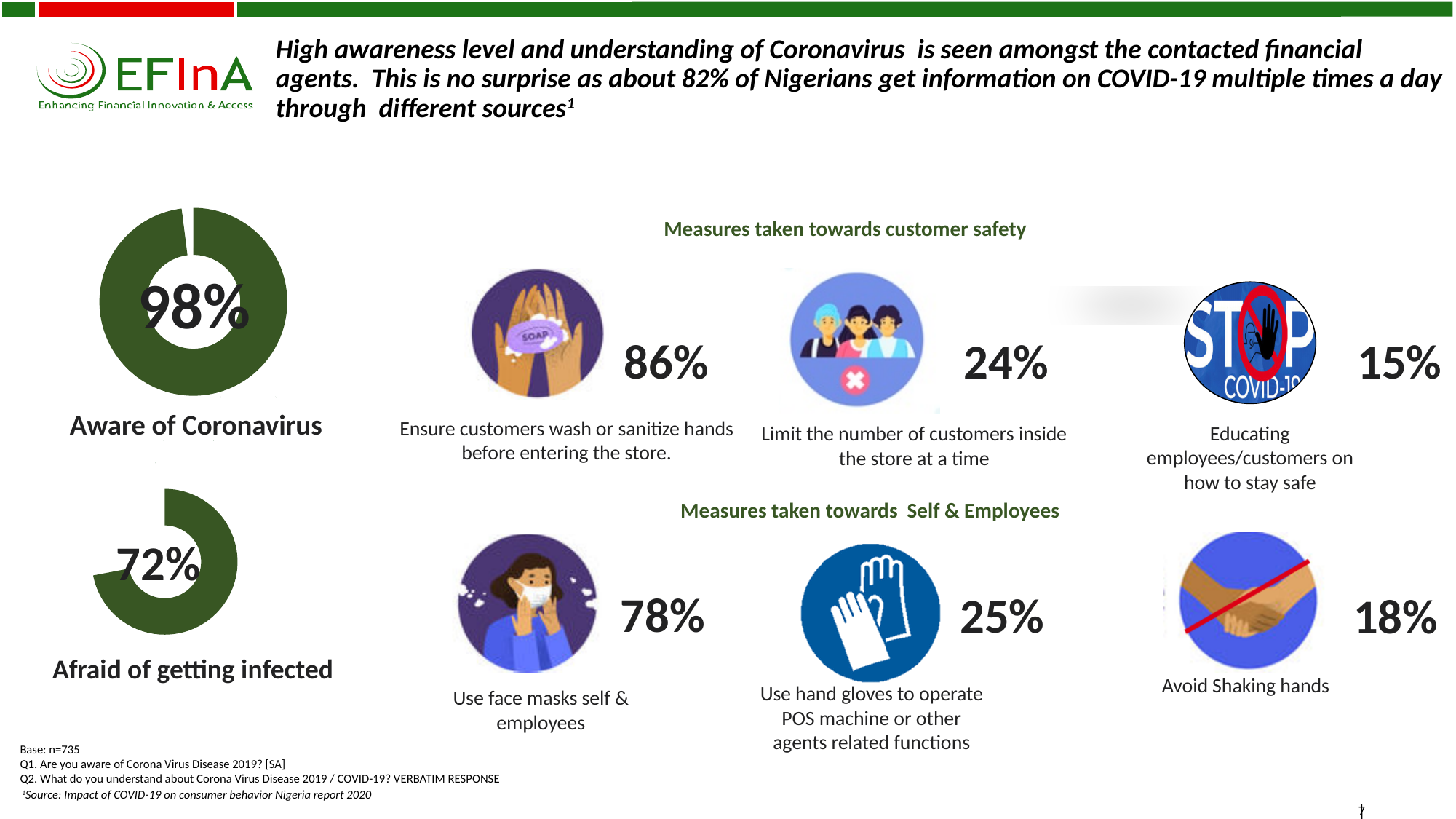
What value does the 'Afraid of getting infected' donut chart show? 72% How many donut charts are shown on the slide? 2 What kind of chart is used to show the 'Afraid of getting infected' figure? Donut chart Is the value shown in the 'Aware of Coronavirus' donut chart greater or less than 90%? greater What is the base sample size (n) stated for the charts on the slide? n=735 What is the difference between the 'Aware of Coronavirus' value and the 'Afraid of getting infected' value? 26% What is the label below the top donut chart on the left of the slide? Aware of Coronavirus What value does the 'Aware of Coronavirus' donut chart show? 98% What colour is the filled portion of the 'Aware of Coronavirus' donut chart? Dark green Is the value shown in the 'Afraid of getting infected' donut chart greater or less than 50%? greater Which of the two donut charts shows the larger value, 'Aware of Coronavirus' or 'Afraid of getting infected'? Aware of Coronavirus What kind of chart is used to show the 'Aware of Coronavirus' figure? Donut chart